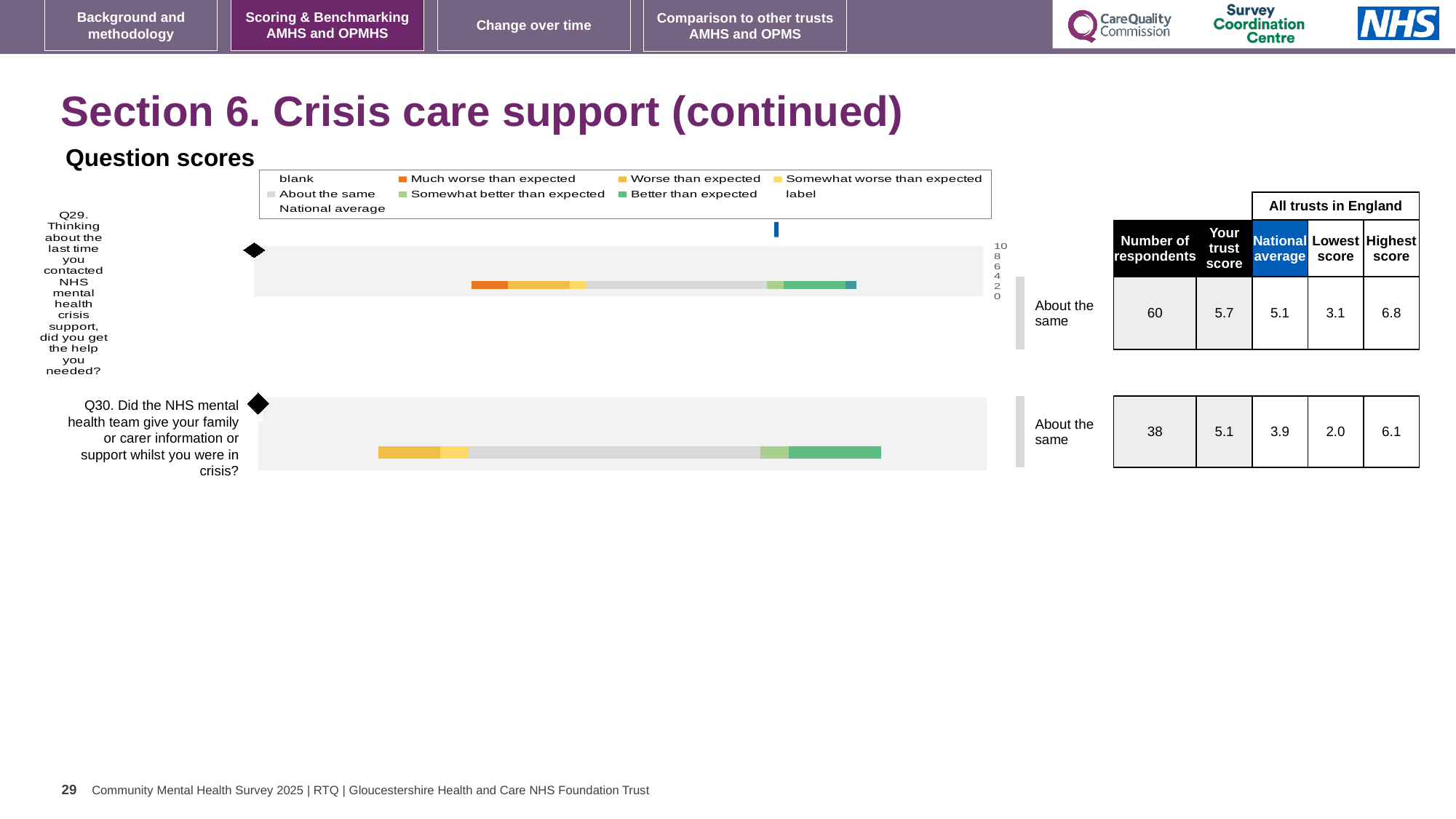
Which question has the higher trust score in the table beside the chart, Q29 or Q30? Q29 How many entries does the legend of the question scores chart list? 9 In the question scores chart, which legend category is shown in orange? Much worse than expected In the question scores chart, which legend category is shown in dark green? Better than expected How many questions (bars) are plotted in the question scores chart? 2 What kind of chart is used to show the question scores for Q29 and Q30? bar chart What is the number of respondents for Q29 in the table beside the chart? 60 What is the benchmark rating shown next to the Q29 bar? About the same What is the trust score for Q30 in the table beside the chart? 5.1 What is the benchmark rating shown next to the Q30 bar? About the same What is the difference between the trust score and the national average for Q30 in the table beside the chart? 1.2 Which of the two bars, Q29 or Q30, includes a 'Much worse than expected' (orange) segment? Q29